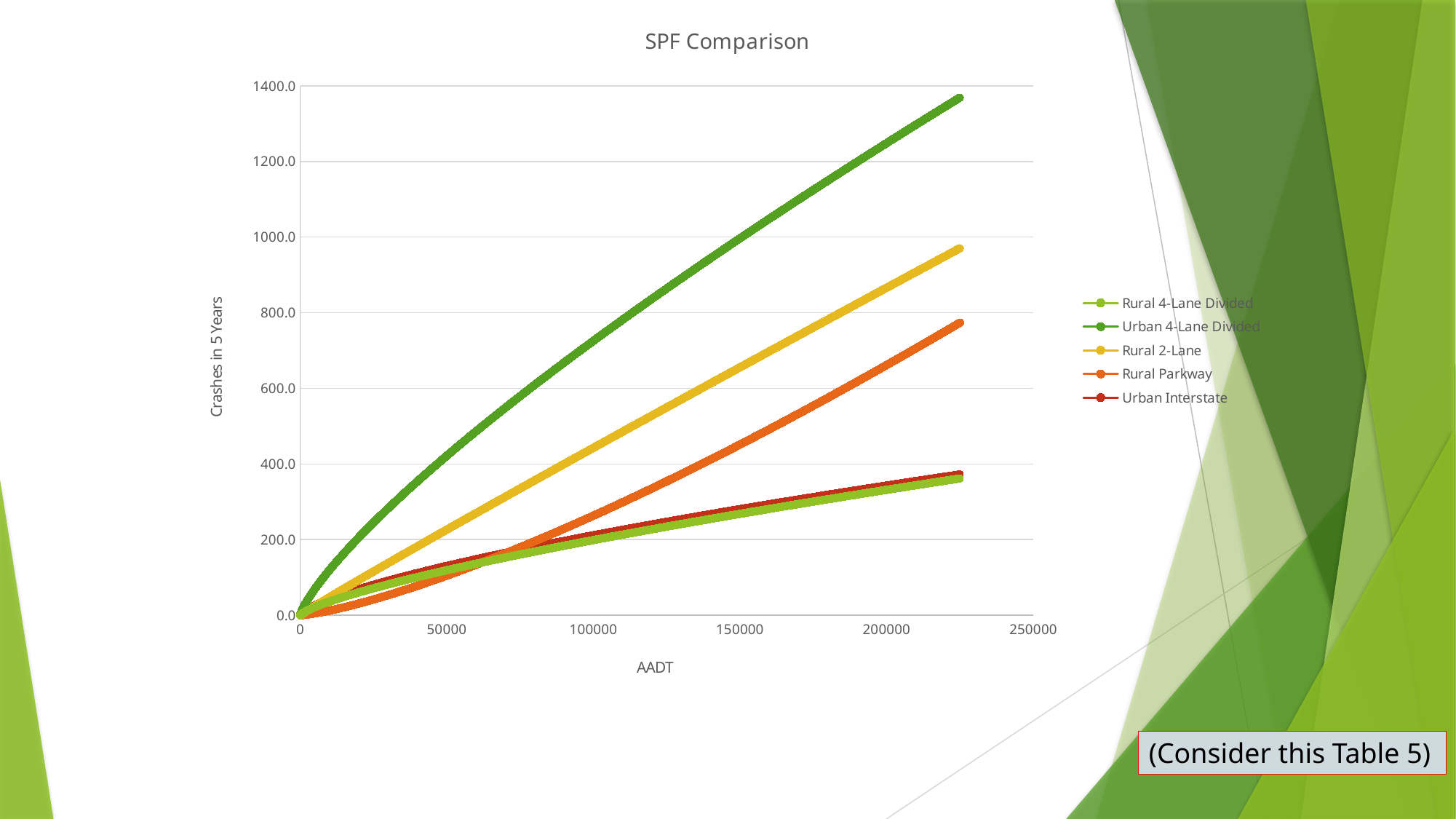
What kind of chart is shown on the slide? Line chart At an AADT of 150000, which series has the larger value: Urban 4-Lane Divided or Rural 2-Lane? Urban 4-Lane Divided Is the value for Urban 4-Lane Divided at its right-most point greater or less than 1200? greater What is the label of the vertical axis? Crashes in 5 Years Is the value for Rural 4-Lane Divided at its right-most point greater or less than 400? less Which series has the highest value at the right end of the chart? Urban 4-Lane Divided How many series does the legend list? 5 At an AADT of 200000, which series has the larger value: Rural 2-Lane or Rural Parkway? Rural 2-Lane Is the value for Rural Parkway at its right-most point greater or less than 600? greater Do the values for Urban 4-Lane Divided rise or fall as AADT increases? Rise What is the title of the chart? SPF Comparison